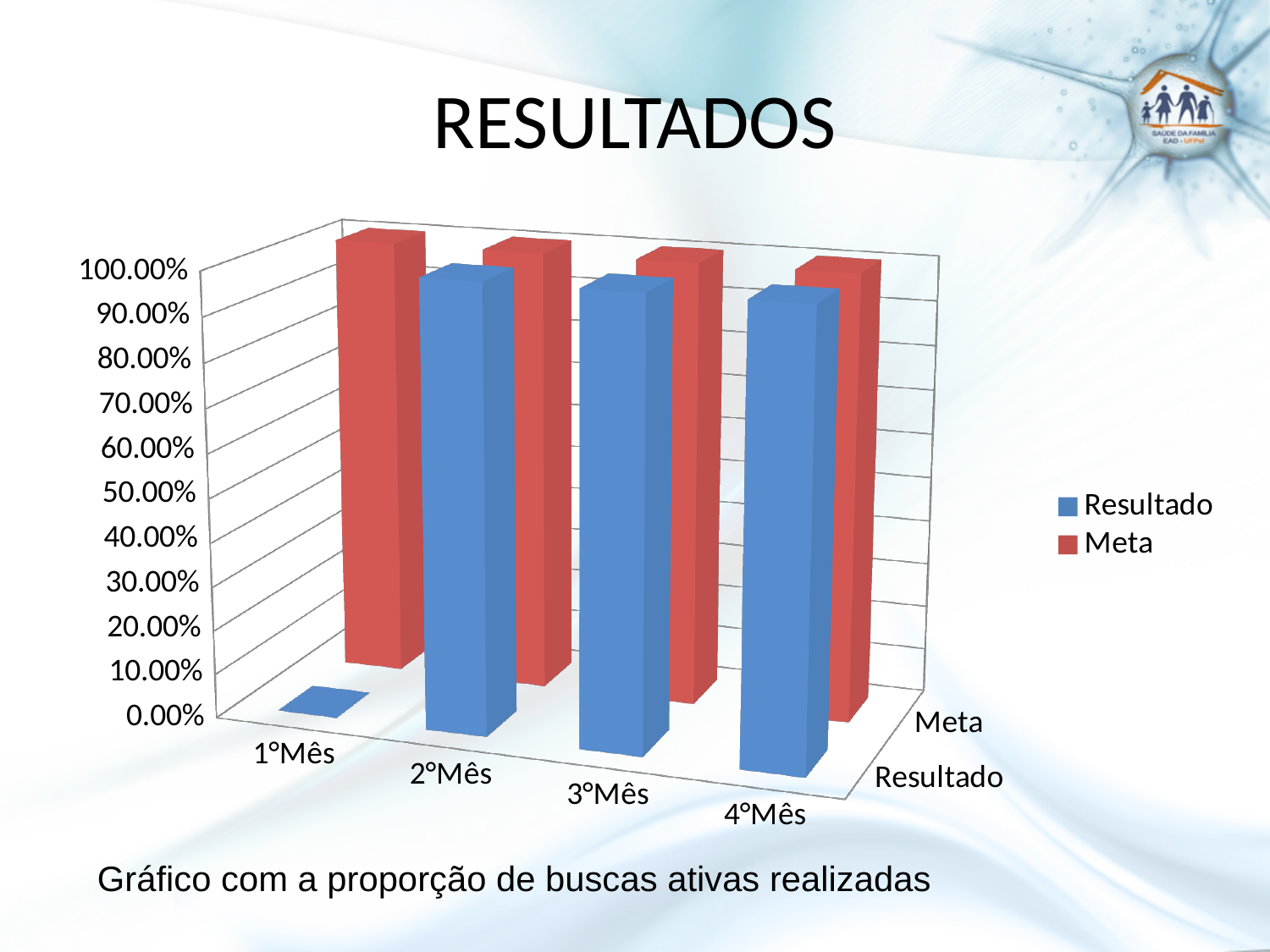
Is the Resultado value for 1°Mês greater or less than 10.00%? less Does the Resultado value rise or fall from 1°Mês to 2°Mês? rise Which is larger, the Resultado value for 1°Mês or the Resultado value for 2°Mês? 2°Mês What are the two entries in the chart legend? Resultado and Meta Which month has the lowest Resultado value? 1°Mês What kind of chart is shown on the slide? bar chart Is the Meta value for 3°Mês greater or less than 90.00%? greater Is the Resultado value for 2°Mês greater or less than 50.00%? greater How many series does the legend list? 2 Which is larger for 1°Mês, Resultado or Meta? Meta What colour are the Meta bars? red How many month categories are shown on the x axis? 4